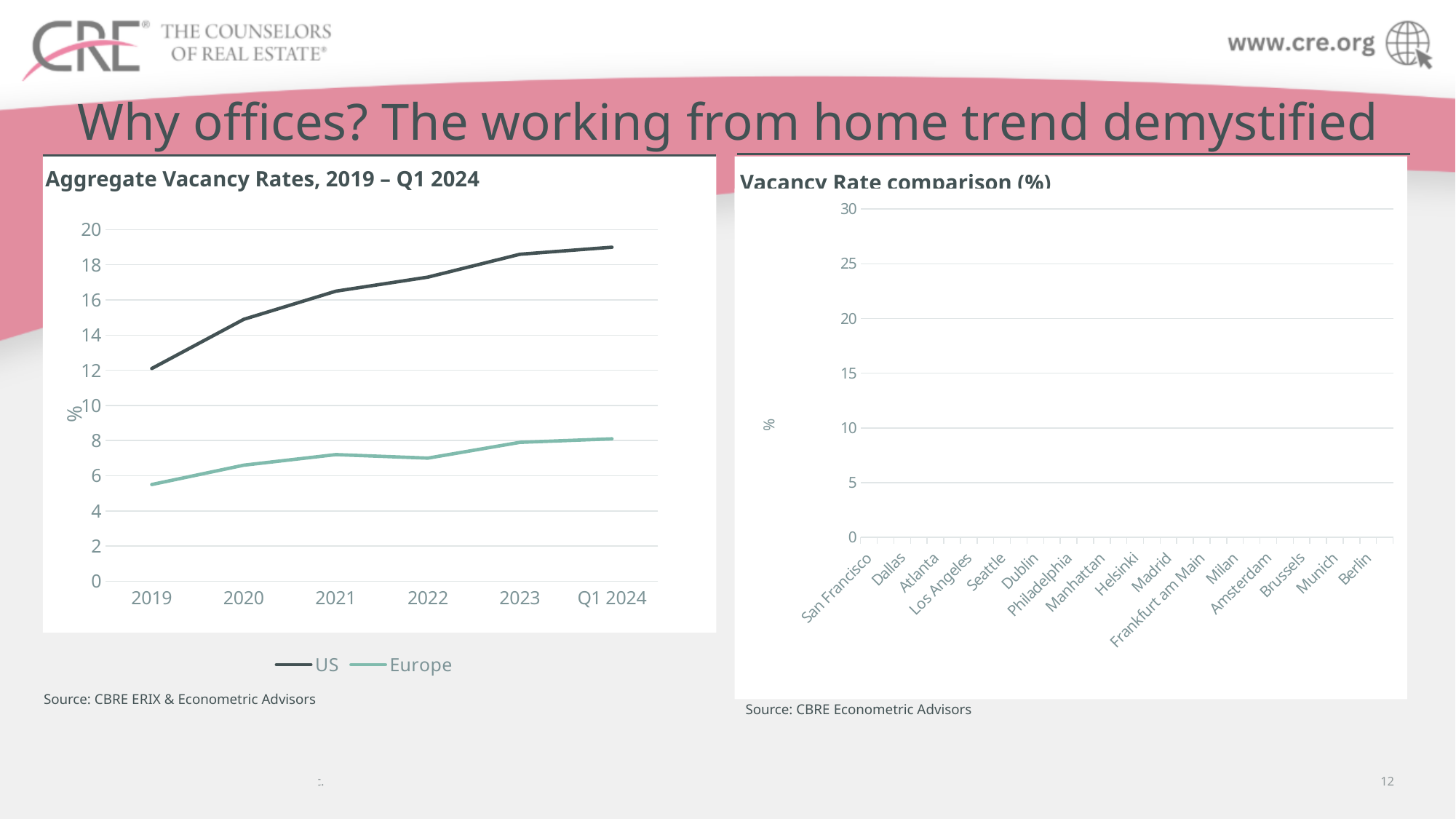
In the 'Aggregate Vacancy Rates, 2019 – Q1 2024' chart, which series has the higher vacancy rate in 2022, US or Europe? US In the 'Aggregate Vacancy Rates, 2019 – Q1 2024' chart, which legend entry is drawn in the dark line colour? US In the 'Aggregate Vacancy Rates, 2019 – Q1 2024' chart, at which time point is the US vacancy rate highest? Q1 2024 In the 'Aggregate Vacancy Rates, 2019 – Q1 2024' chart, is the US value for Q1 2024 greater or less than 20? less What kind of chart is the 'Aggregate Vacancy Rates, 2019 – Q1 2024' chart? line chart How many series does the legend of the 'Aggregate Vacancy Rates, 2019 – Q1 2024' chart list? 2 In the 'Aggregate Vacancy Rates, 2019 – Q1 2024' chart, at which time point is the Europe vacancy rate lowest? 2019 In the 'Aggregate Vacancy Rates, 2019 – Q1 2024' chart, does the US vacancy rate rise or fall from 2019 to Q1 2024? rise How many time points are plotted along the x axis of the 'Aggregate Vacancy Rates, 2019 – Q1 2024' chart? 6 In the 'Aggregate Vacancy Rates, 2019 – Q1 2024' chart, is the Europe value for 2019 greater or less than 6? less In the 'Aggregate Vacancy Rates, 2019 – Q1 2024' chart, is the US value for 2021 greater or less than 16? greater